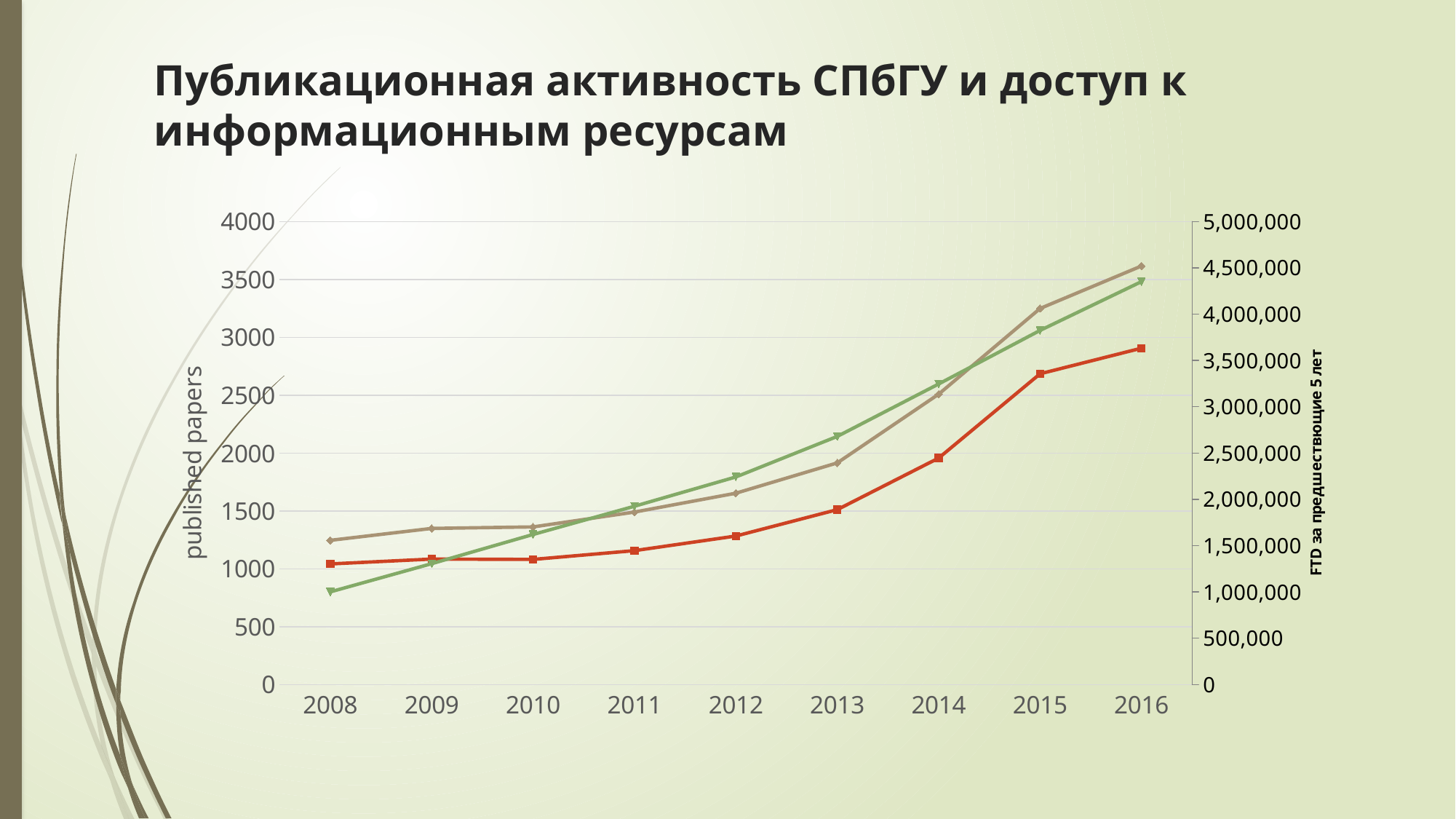
What is the first year shown on the x axis? 2008 How many lines are plotted on the chart? 3 Do the values of the green line rise or fall from 2008 to 2016? rise What is the last year shown on the x axis? 2016 What is the title of the left vertical axis? published papers Reading against the left axis, is the red line's value in 2015 greater or less than 2500? greater Reading against the left axis, is the green line's value in 2008 greater or less than 1000? less What kind of chart is shown on the slide? line chart What is the title of the right vertical axis? FTD за предшествующие 5 лет Which of the three lines is plotted lowest in 2016? the red line Do the values of the red line rise or fall from 2008 to 2016? rise How many years are shown along the x axis of the chart? 9